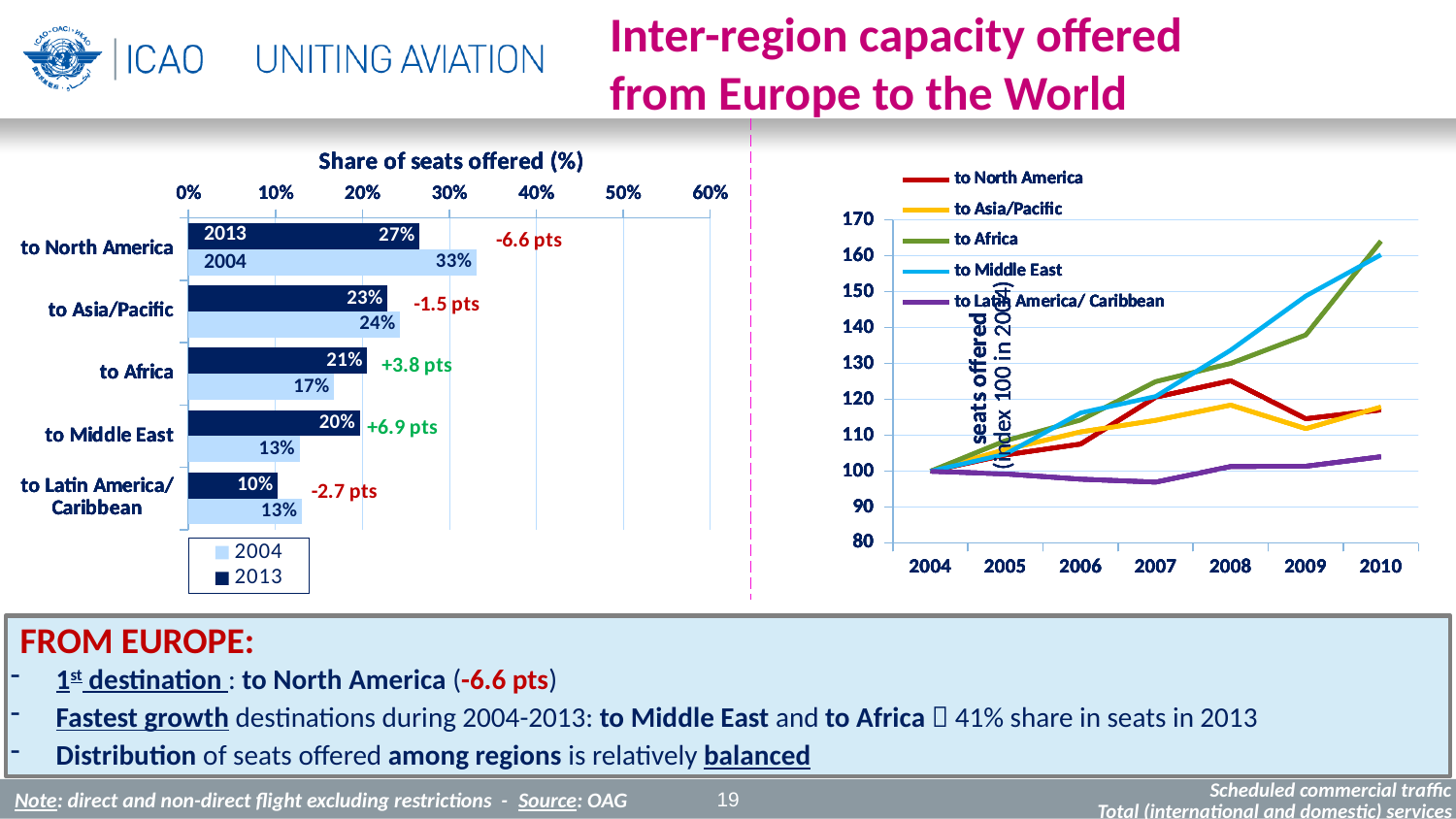
How many series does the legend of the line chart on the right list? 5 How many series does the legend of the 'Share of seats offered (%)' chart list? 2 In the 'Share of seats offered (%)' chart, what is the difference between the 2004 and 2013 shares for to Africa? 4 percentage points In the 'Share of seats offered (%)' chart, what is the 2013 share for to North America? 27% What type of chart is the chart on the right side of the slide? line chart In the 'Share of seats offered (%)' chart, which region has the highest 2004 share? to North America In the line chart on the right, is the 2010 value for to Latin America/ Caribbean greater or less than 110? less In the 'Share of seats offered (%)' chart, is the 2013 share for to Asia/Pacific larger or smaller than the 2013 share for to Africa? larger In the 'Share of seats offered (%)' chart, what is the 2004 share for to Middle East? 13% How many regions are shown in the 'Share of seats offered (%)' chart? 5 In the 'Share of seats offered (%)' chart, which region has the lowest 2013 share? to Latin America/ Caribbean In the line chart on the right, is the 2010 value for to Africa greater or less than 150? greater